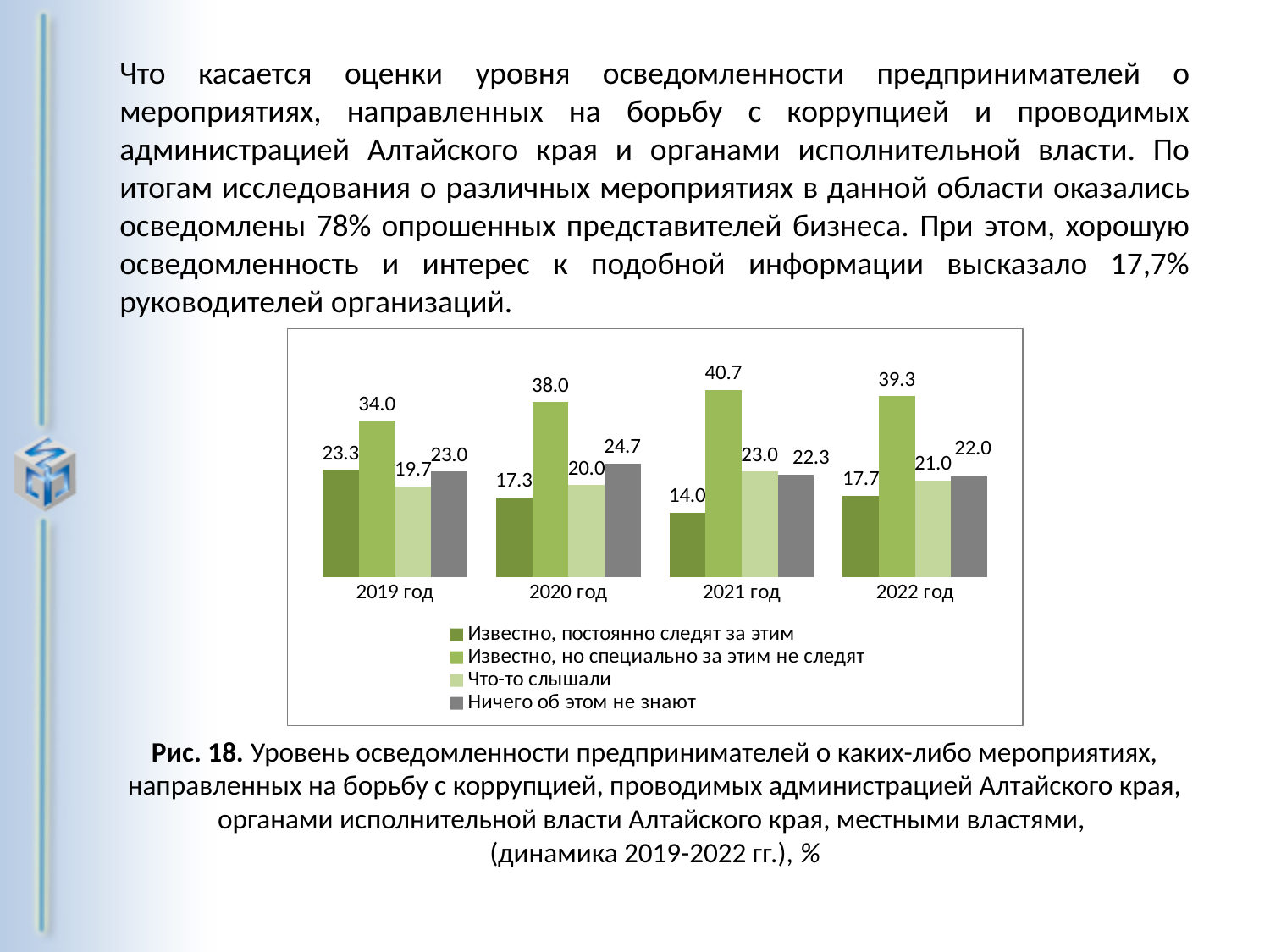
What is the value for "Ничего об этом не знают" in 2020 год? 24.7 In which year is the value for "Известно, но специально за этим не следят" highest? 2021 год What is the value for "Что-то слышали" in 2022 год? 21.0 What is the difference between the values for "Известно, но специально за этим не следят" in 2021 год and 2019 год? 6.7 What kind of chart is shown on the slide? Bar chart Which is larger in 2022 год: "Известно, постоянно следят за этим" or "Ничего об этом не знают"? Ничего об этом не знают What is the value for "Известно, но специально за этим не следят" in 2021 год? 40.7 Does the value for "Известно, постоянно следят за этим" rise or fall from 2019 год to 2021 год? Fall How many series does the legend list? 4 How many year categories are shown on the x axis? 4 What is the value for "Известно, постоянно следят за этим" in 2019 год? 23.3 In which year is the value for "Известно, постоянно следят за этим" lowest? 2021 год